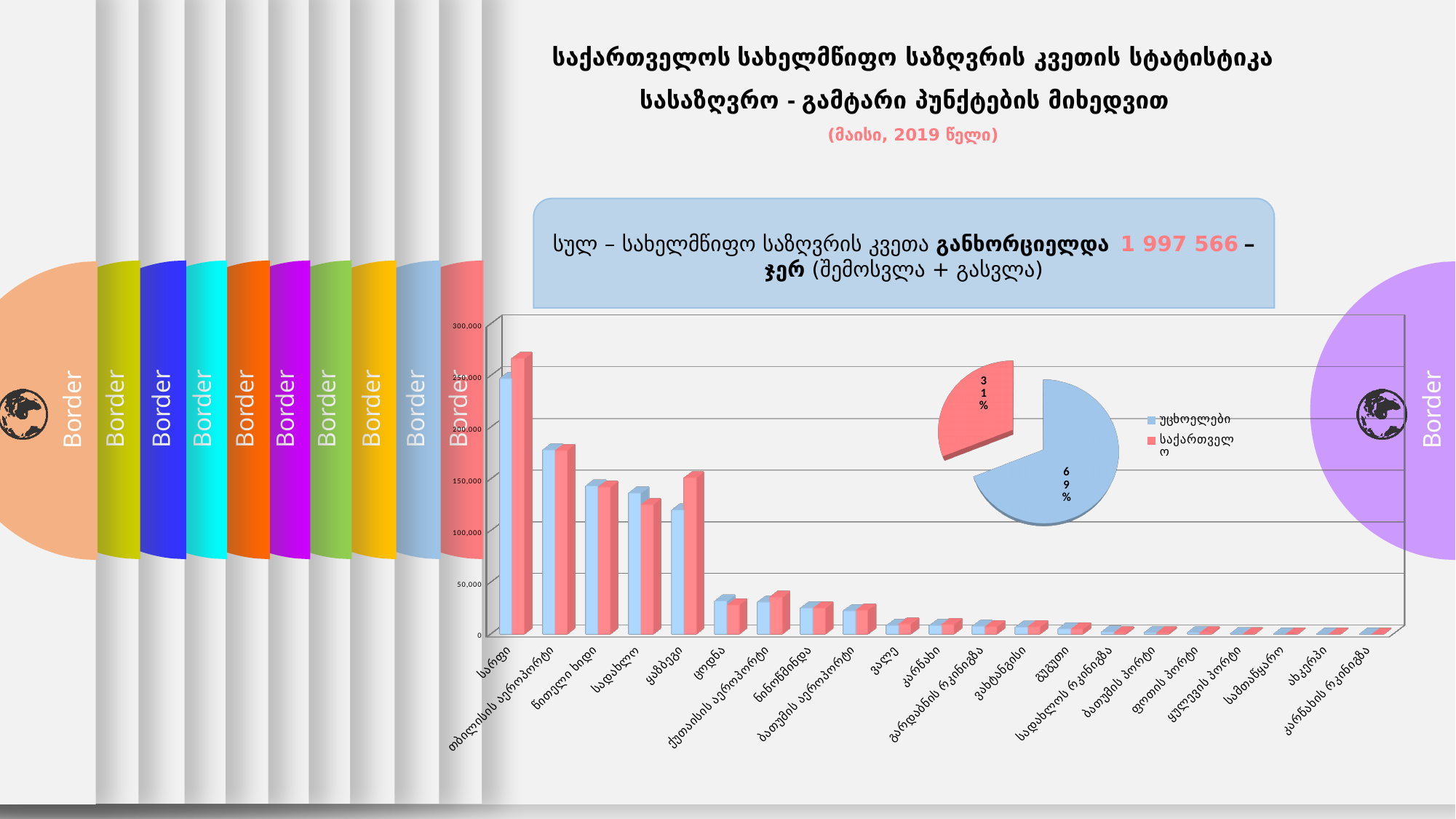
In the pie chart, what share is shown for საქართველო? 31% In the bar chart, is the blue bar for სარფი greater or less than 200,000? greater What kind of chart is the large chart at the bottom left of the slide? bar chart In the bar chart, for ყაზბეგი, is the red bar or the blue bar taller? red In the pie chart, what is the difference in percentage points between the უცხოელები slice and the საქართველო slice? 38 percentage points How many categories are shown on the x axis of the bar chart? 21 How many entries does the legend of the pie chart list? 2 In the bar chart, is the blue bar for ცოდნა greater or less than 50,000? less In the pie chart, which slice is larger, უცხოელები or საქართველო? უცხოელები In the bar chart, which category has the highest values? სარფი In the bar chart, do the values generally rise or fall moving from left to right along the x axis? fall In the pie chart, what share is shown for უცხოელები? 69%